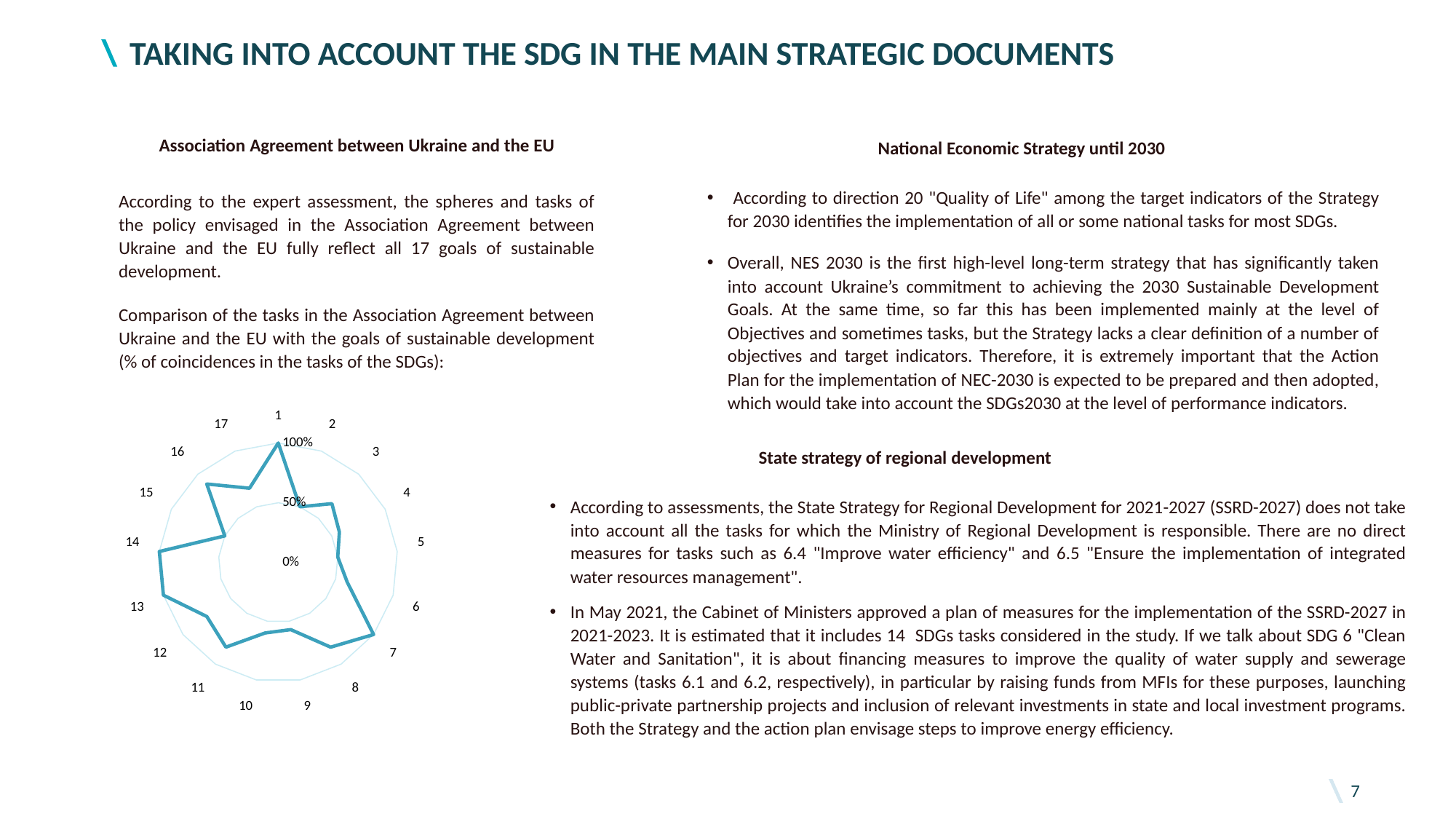
Is the value for category 11 on the radar chart greater or less than 50%? greater Is the value for category 14 on the radar chart greater or less than 50%? greater What kind of chart is shown on the slide? Radar chart Is the value for category 7 on the radar chart greater or less than 50%? greater What value does the radar chart show for category 1? 100% According to the text above the chart, what does the radar chart compare? Tasks in the Association Agreement between Ukraine and the EU with the SDGs (% of coincidences in the tasks of the SDGs) Which has the larger value on the radar chart, category 7 or category 9? Category 7 What are the percentage tick labels shown on the radar chart's axis? 0%, 50%, 100% How many data series are plotted on the radar chart? 1 Which has the larger value on the radar chart, category 1 or category 15? Category 1 How many categories (SDG numbers) are plotted on the radar chart? 17